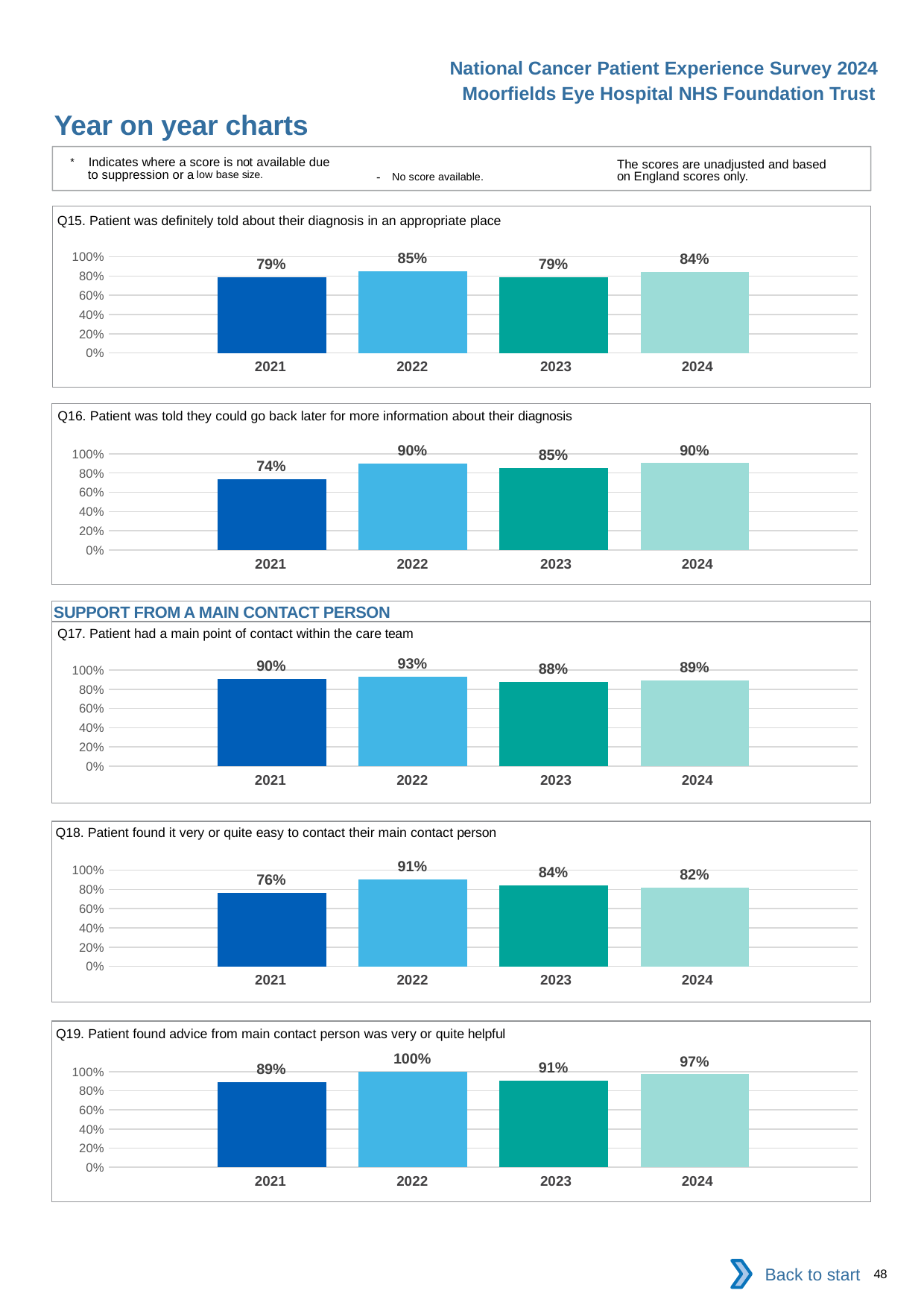
In the Q18 chart, which is larger, the value for 2021 or the value for 2024? 2024 What kind of chart is the Q16 chart? bar chart How many years are shown in the Q15 chart? 4 In the Q17 chart, what is the difference between the 2022 and 2023 values? 5% In the Q16 chart, which year has the lowest value? 2021 What is the section heading shown above the Q17 chart? SUPPORT FROM A MAIN CONTACT PERSON In the Q18 chart, is the value for 2021 greater or less than 60%? greater In the Q17 chart, what is the value for 2021? 90% In the Q19 chart, what is the value for 2024? 97% In the Q15 chart, what is the value for 2022? 85% In the Q16 chart, what is the difference between the 2024 and 2021 values? 16% In the Q19 chart, which year has the highest value? 2022